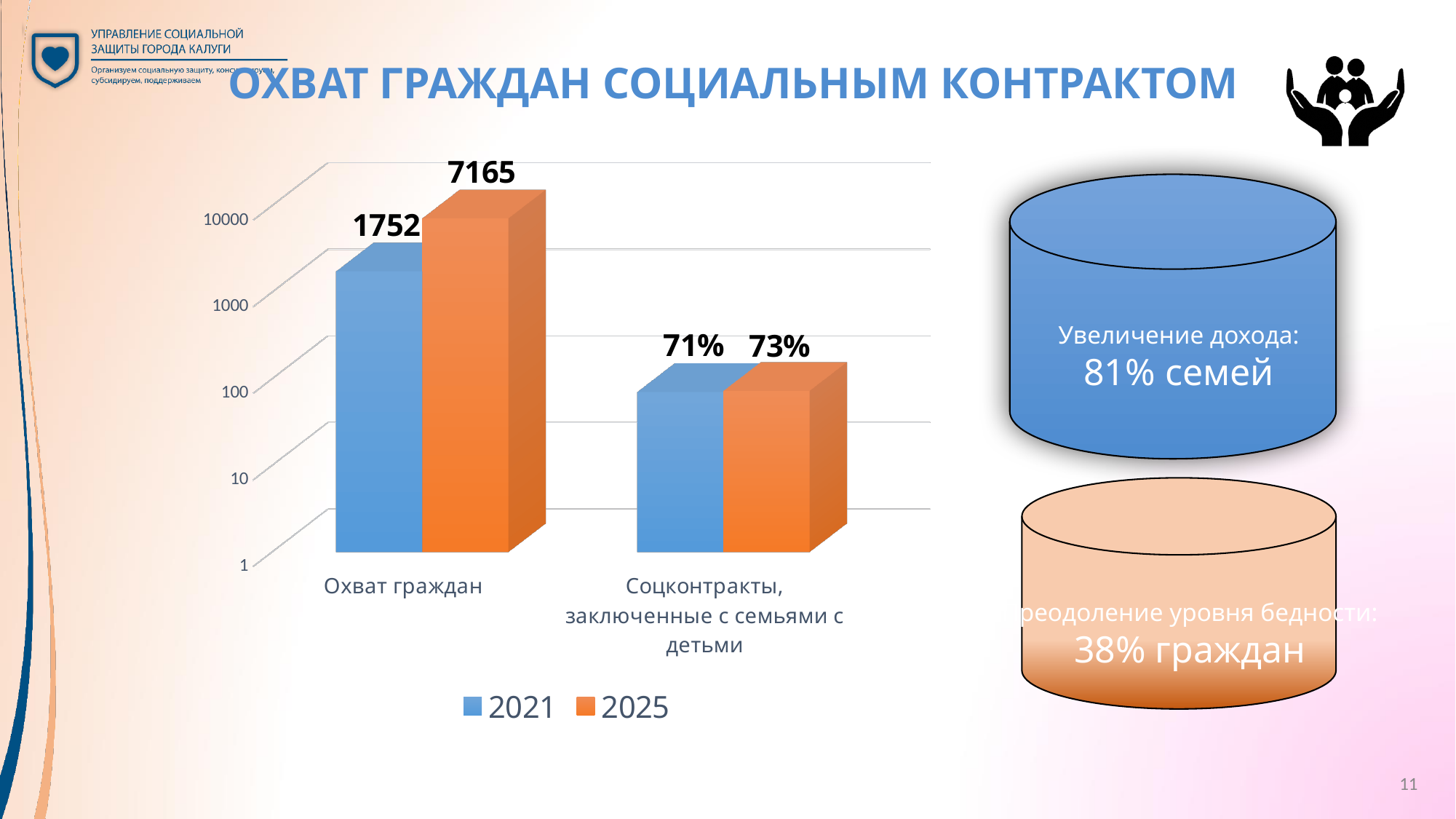
What is the difference between the 2025 and 2021 values for "Охват граждан"? 5413 How many series does the chart legend list? 2 What kind of chart is shown on the slide? bar chart What is the value for 2025 in the "Соцконтракты, заключенные с семьями с детьми" category? 73% What is the value for 2021 in the "Охват граждан" category? 1752 Is the 2021 value for "Охват граждан" greater or less than 1000? greater Which colour represents the 2025 series in the chart? orange What is the value for 2021 in the "Соцконтракты, заключенные с семьями с детьми" category? 71% What is the value for 2025 in the "Охват граждан" category? 7165 How many categories are shown on the x axis of the chart? 2 Is the 2025 value for "Охват граждан" greater or less than 10000? less Which series has the larger value for "Охват граждан", 2021 or 2025? 2025